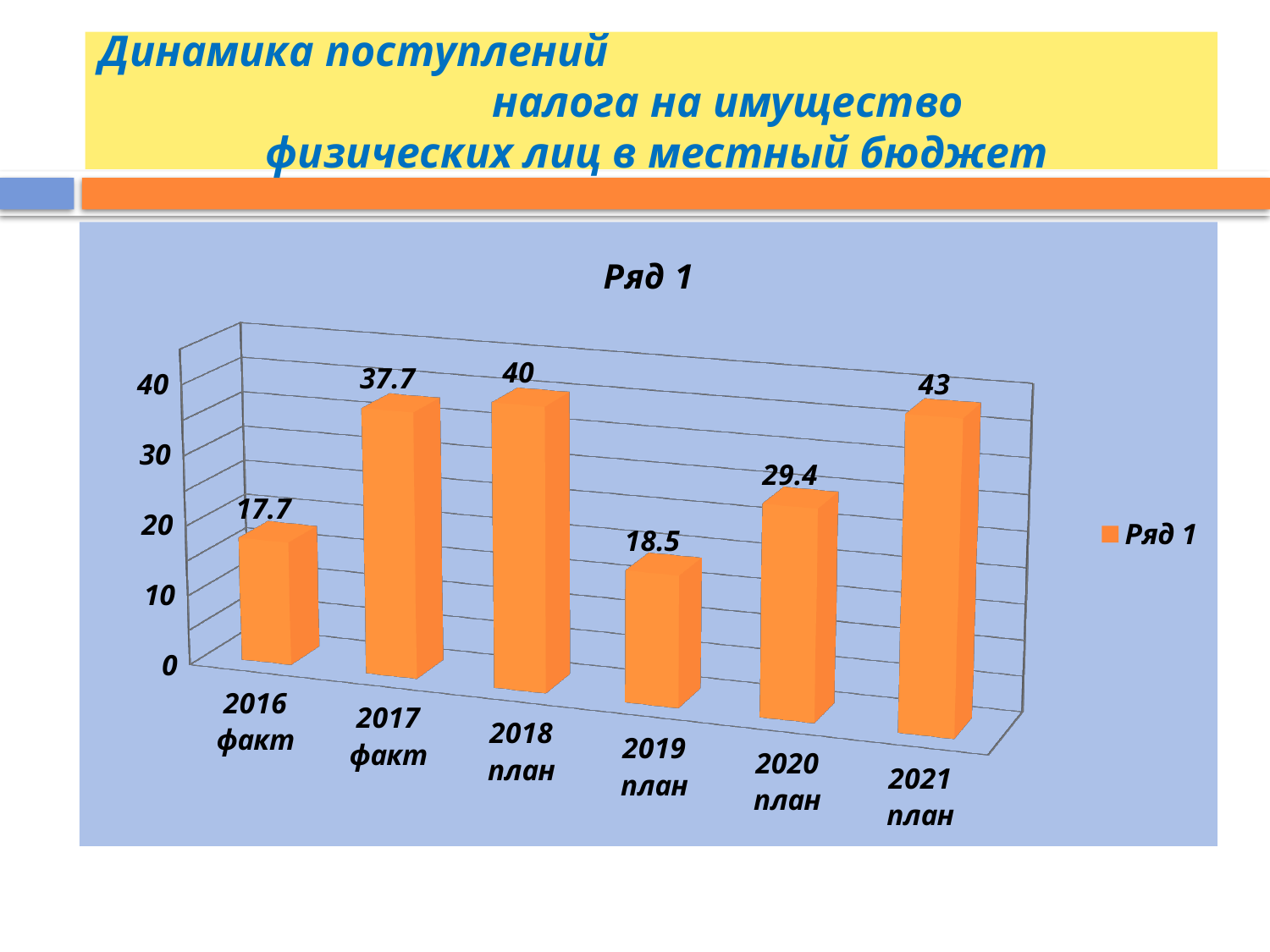
What is the difference between the values for 2018 план and 2017 факт? 2.3 Which category has the lowest value? 2016 факт What is the difference between the values for 2021 план and 2016 факт? 25.3 What kind of chart is shown on the slide? bar chart What is the value for 2019 план? 18.5 What is the value for 2016 факт? 17.7 How many series does the legend list? 1 Which category has the highest value? 2021 план Which is larger, the value for 2017 факт or the value for 2020 план? 2017 факт What is the value for 2020 план? 29.4 Is the value for 2019 план greater or less than 20? less How many categories are shown on the x axis? 6